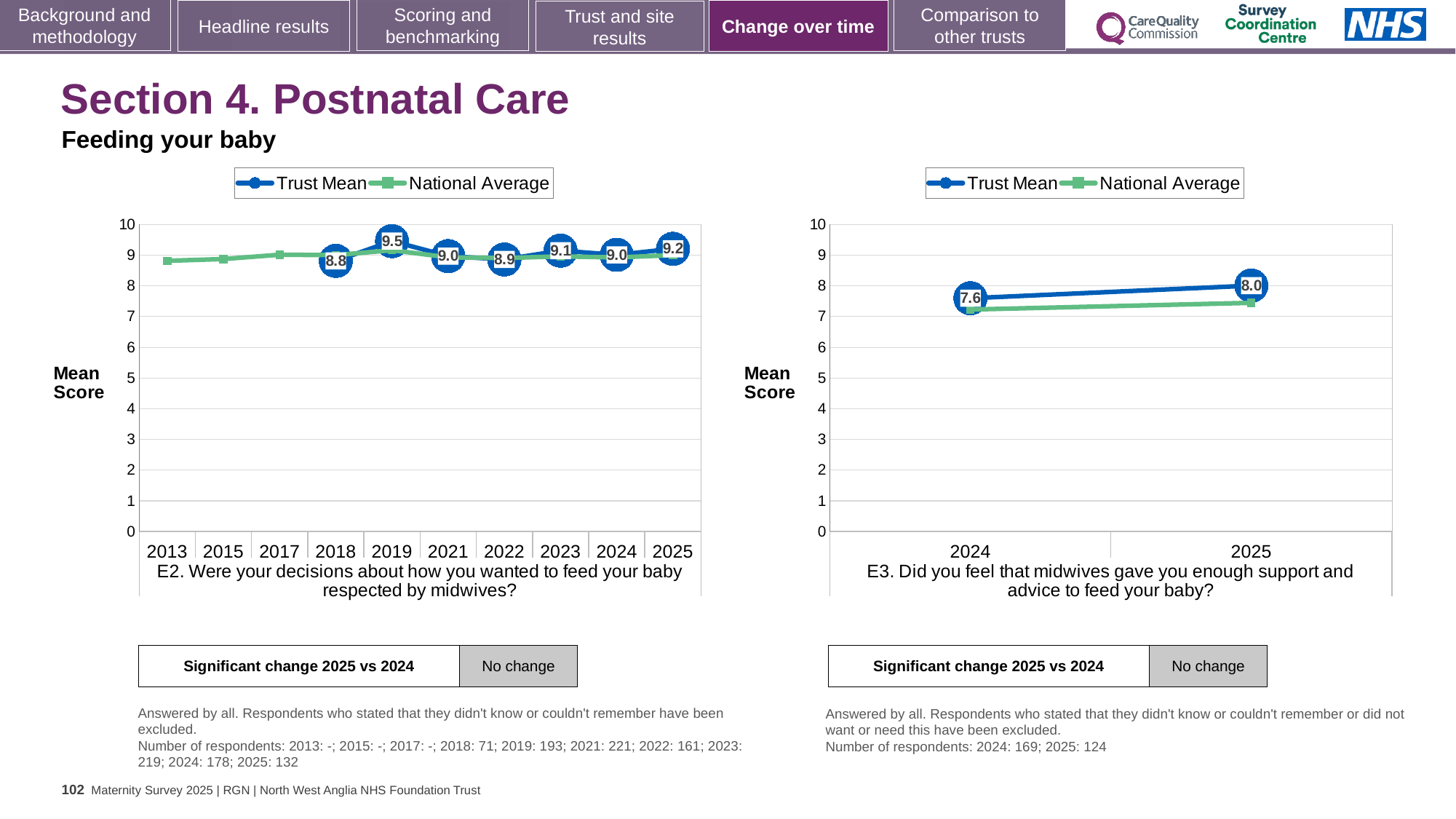
In the E2 chart (left), what is the difference between the Trust Mean in 2019 and in 2018? 0.7 How many series does the legend of the E3 chart (right) list? 2 In the E2 chart (left), which year has the lowest labelled Trust Mean? 2018 In the E3 chart (right), did the Trust Mean rise or fall from 2024 to 2025? rise In the E2 chart (left), which year has the highest Trust Mean? 2019 In the E3 chart (right), is the National Average for 2024 greater or less than 8? less In the E3 chart (right), what is the Trust Mean for 2024? 7.6 In the E3 chart (right), what is the Trust Mean for 2025? 8.0 What kind of chart is the E2 chart (left)? line chart In the E2 chart (left), how many years are shown on the x axis? 10 In the E2 chart (left), what is the Trust Mean for 2019? 9.5 In the E2 chart (left), what is the Trust Mean for 2025? 9.2